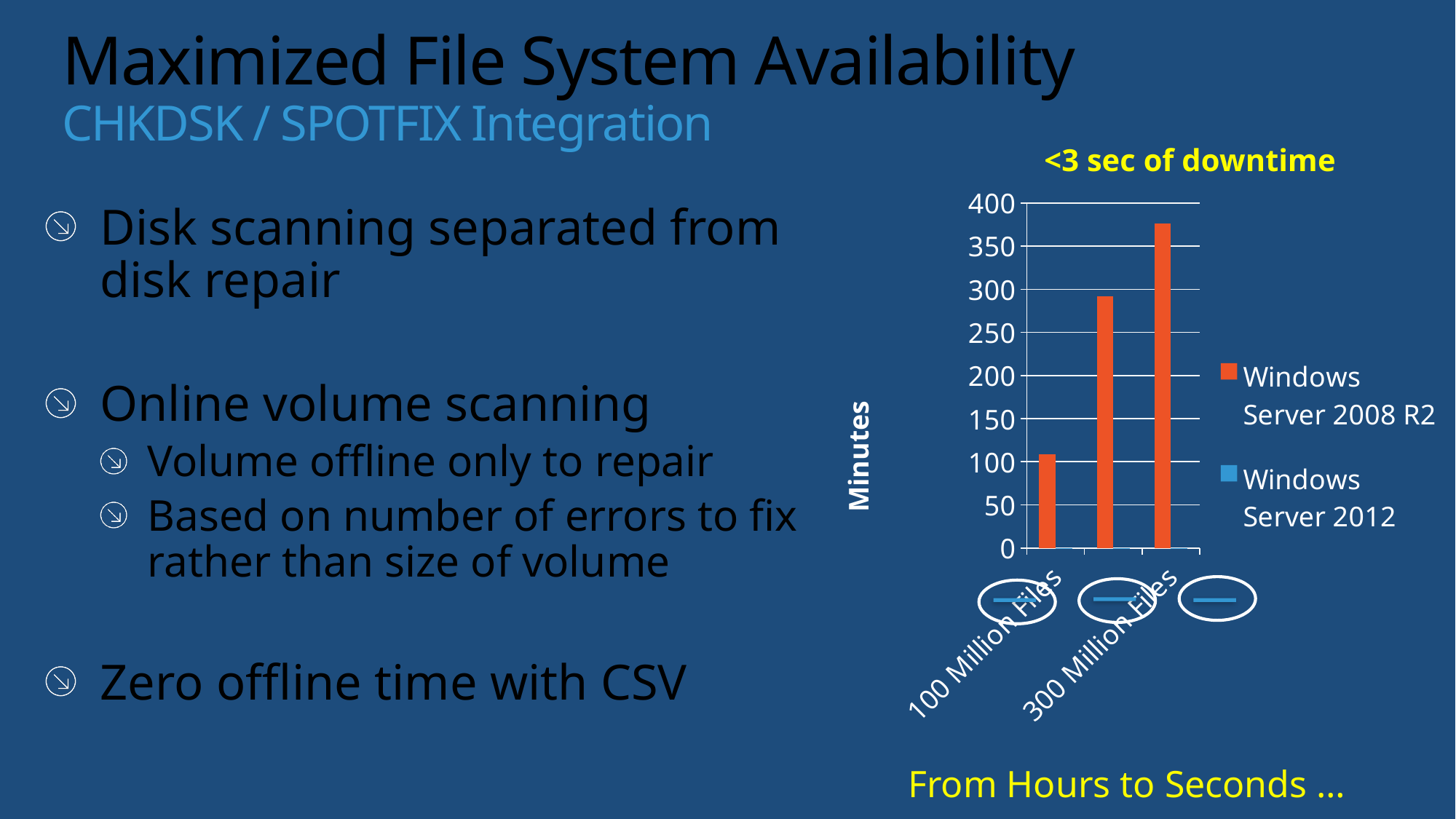
Is the Windows Server 2008 R2 value for 300 Million Files greater or less than 300 minutes? greater How many series does the chart legend list? 2 How many orange bars are plotted in the chart? 3 Which is larger for Windows Server 2008 R2: the value for 100 Million Files or for 300 Million Files? 300 Million Files Do the Windows Server 2008 R2 bars rise or fall from left to right along the x axis? rise Is the Windows Server 2008 R2 value for 300 Million Files greater or less than 250 minutes? greater What is the label of the chart's vertical axis? Minutes What are the two series named in the chart legend? Windows Server 2008 R2 and Windows Server 2012 Which category has the lowest Windows Server 2008 R2 value? 100 Million Files What kind of chart is shown on the slide? bar chart Is the rightmost bar in the chart greater or less than 350 minutes? greater